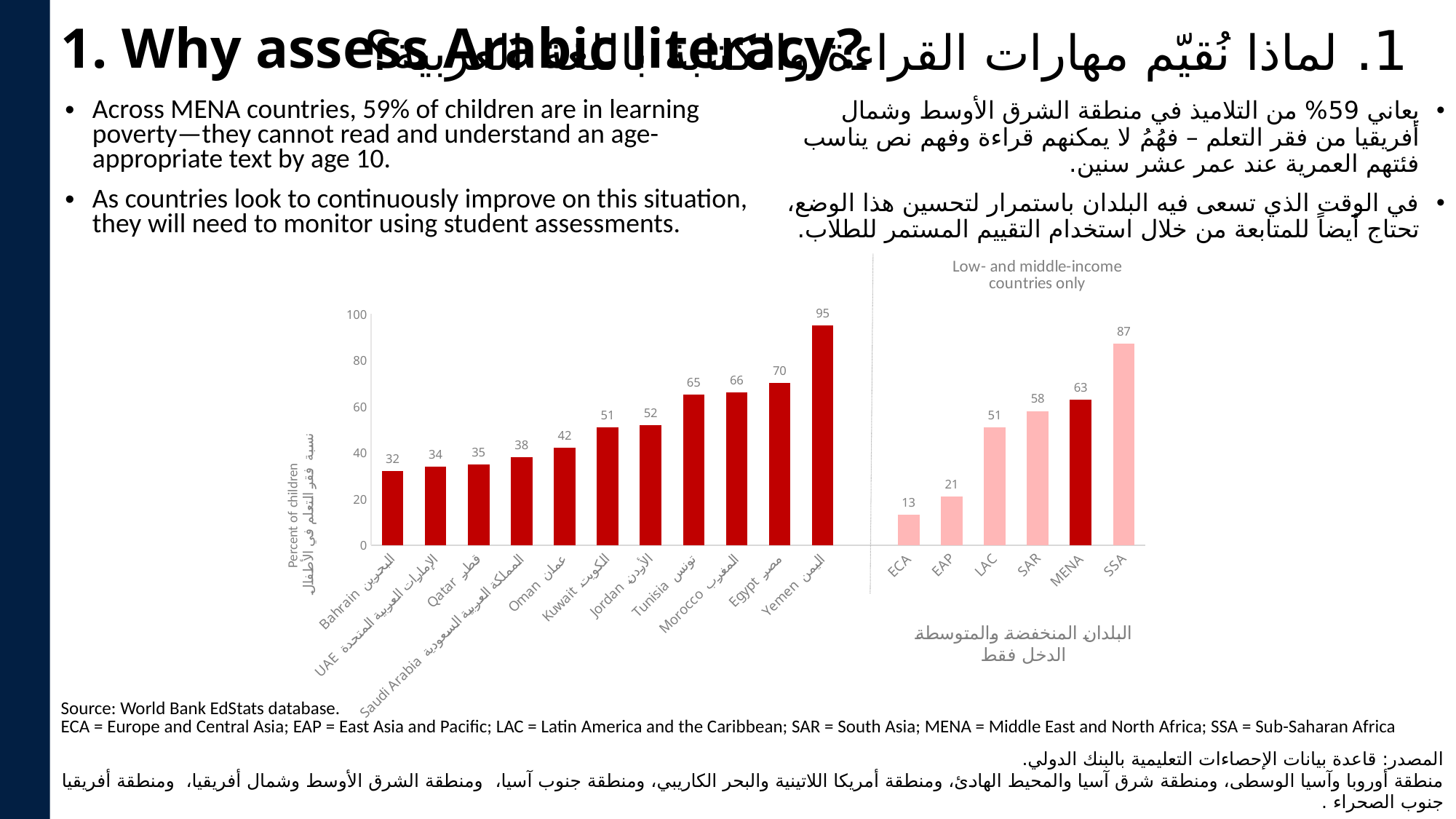
What kind of chart is shown on the slide? bar chart In the left panel of the chart (countries), what is the value for Bahrain? 32 In the left panel of the chart (countries), what is the value for Yemen? 95 In the left panel of the chart (countries), which is larger, the value for Kuwait or the value for Tunisia? Tunisia How many regions are shown in the right panel of the chart? 6 In the right panel of the chart (regions), which region has the lowest value? ECA How many countries are shown in the left panel of the chart? 11 In the right panel of the chart (regions), what is the difference between SSA and MENA? 24 In the left panel of the chart (countries), which country has the highest value? Yemen In the left panel of the chart (countries), is the value for Oman greater or less than 60? less In the right panel of the chart (regions), what is the value for MENA? 63 In the left panel of the chart (countries), what is the difference between Egypt and Bahrain? 38